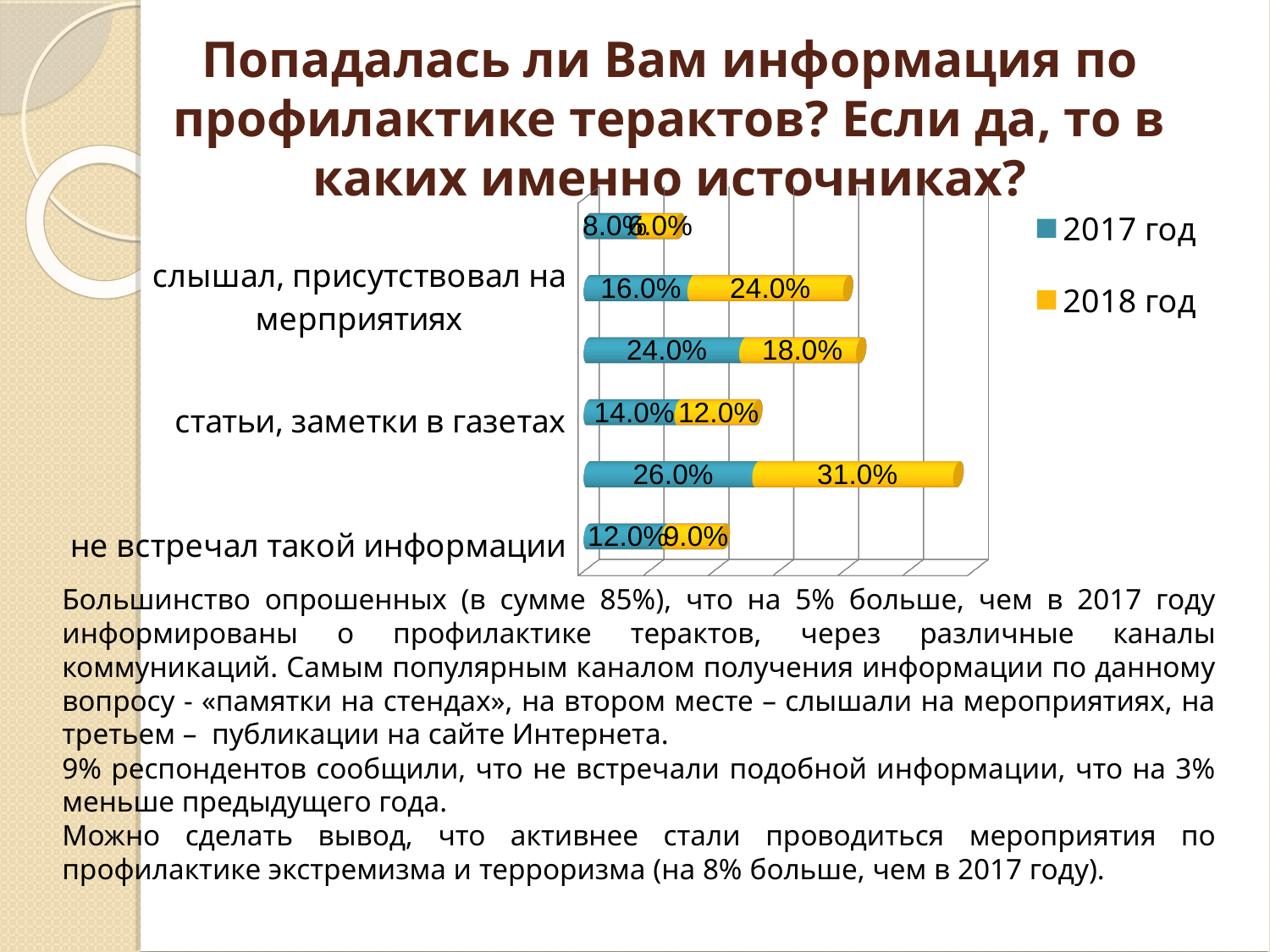
What kind of chart is shown on the slide? bar chart What is the 2017 год value for "статьи, заметки в газетах"? 14.0% What is the 2018 год value for "не встречал такой информации"? 9.0% What is the 2017 год value for "слышал, присутствовал на мерприятиях"? 16.0% What is the total of the stacked bar for "слышал, присутствовал на мерприятиях"? 40.0% For "статьи, заметки в газетах", which series has the larger value, 2017 год or 2018 год? 2017 год By how much does the 2018 год value exceed the 2017 год value for "слышал, присутствовал на мерприятиях"? 8.0% How many series does the legend list? 2 What is the 2018 год value for "слышал, присутствовал на мерприятиях"? 24.0% What is the 2018 год value for "статьи, заметки в газетах"? 12.0% Among the labelled categories "слышал, присутствовал на мерприятиях", "статьи, заметки в газетах" and "не встречал такой информации", which has the highest 2018 год value? слышал, присутствовал на мерприятиях What is the 2017 год value for "не встречал такой информации"? 12.0%